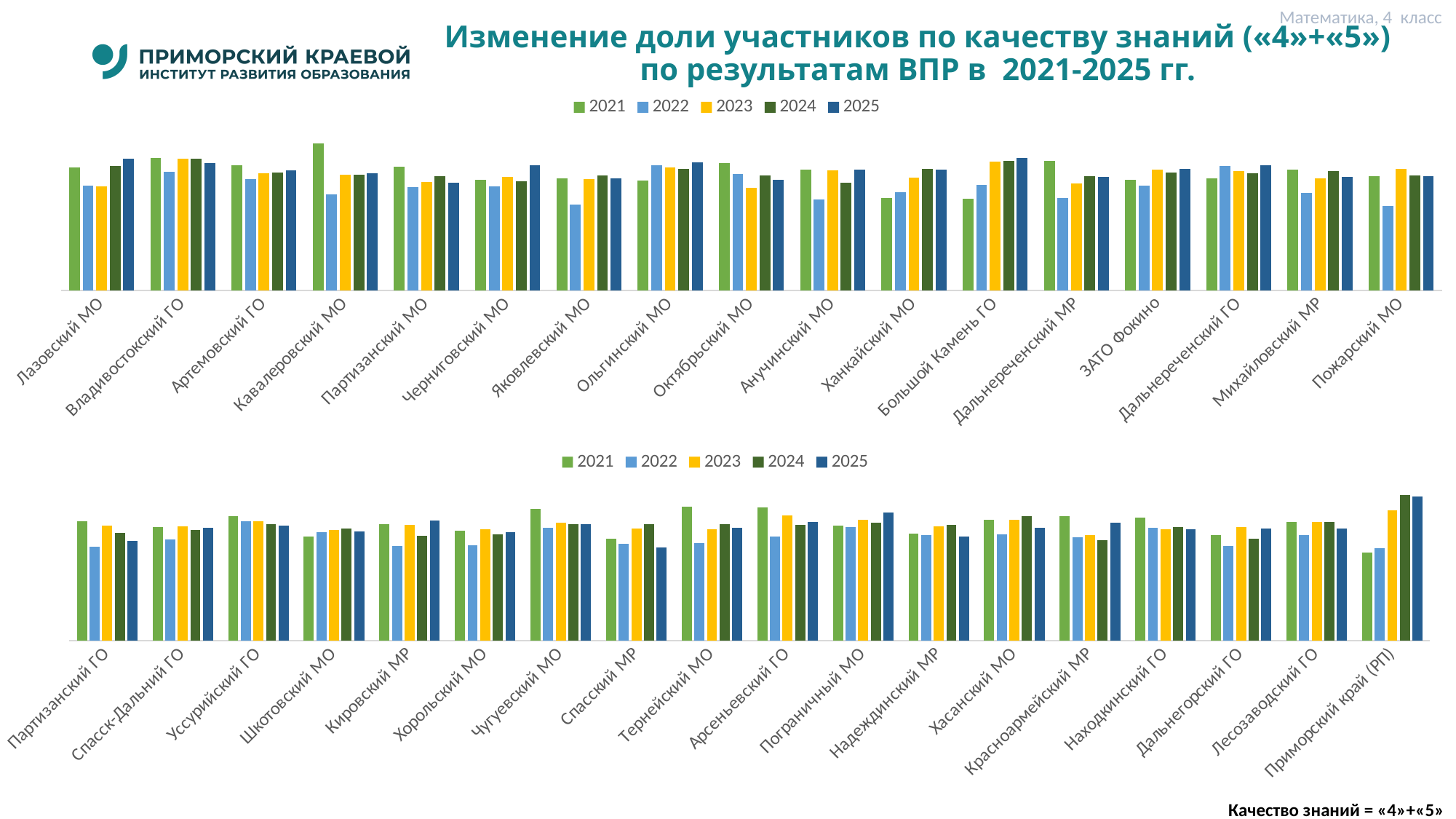
In the bottom chart, for Приморский край (РП), which year has the lowest value? 2021 In the top chart, which category has the tallest 2021 bar? Кавалеровский МО How many categories are shown along the x axis of the bottom chart? 18 What range of years is named in the title of the slide's charts? 2021-2025 Which year does the yellow colour represent in the legend of the charts? 2023 In the bottom chart, which category has the tallest 2024 bar? Приморский край (РП) In the top chart, for Яковлевский МО, which year has the lowest value? 2022 What kind of chart is shown at the top of the slide? bar chart How many categories are shown along the x axis of the top chart? 17 How many series does the legend of the top chart list? 5 In the top chart, for Кавалеровский МО, which is larger: the 2021 value or the 2022 value? 2021 In the bottom chart, for Тернейский МО, which is larger: the 2021 value or the 2022 value? 2021